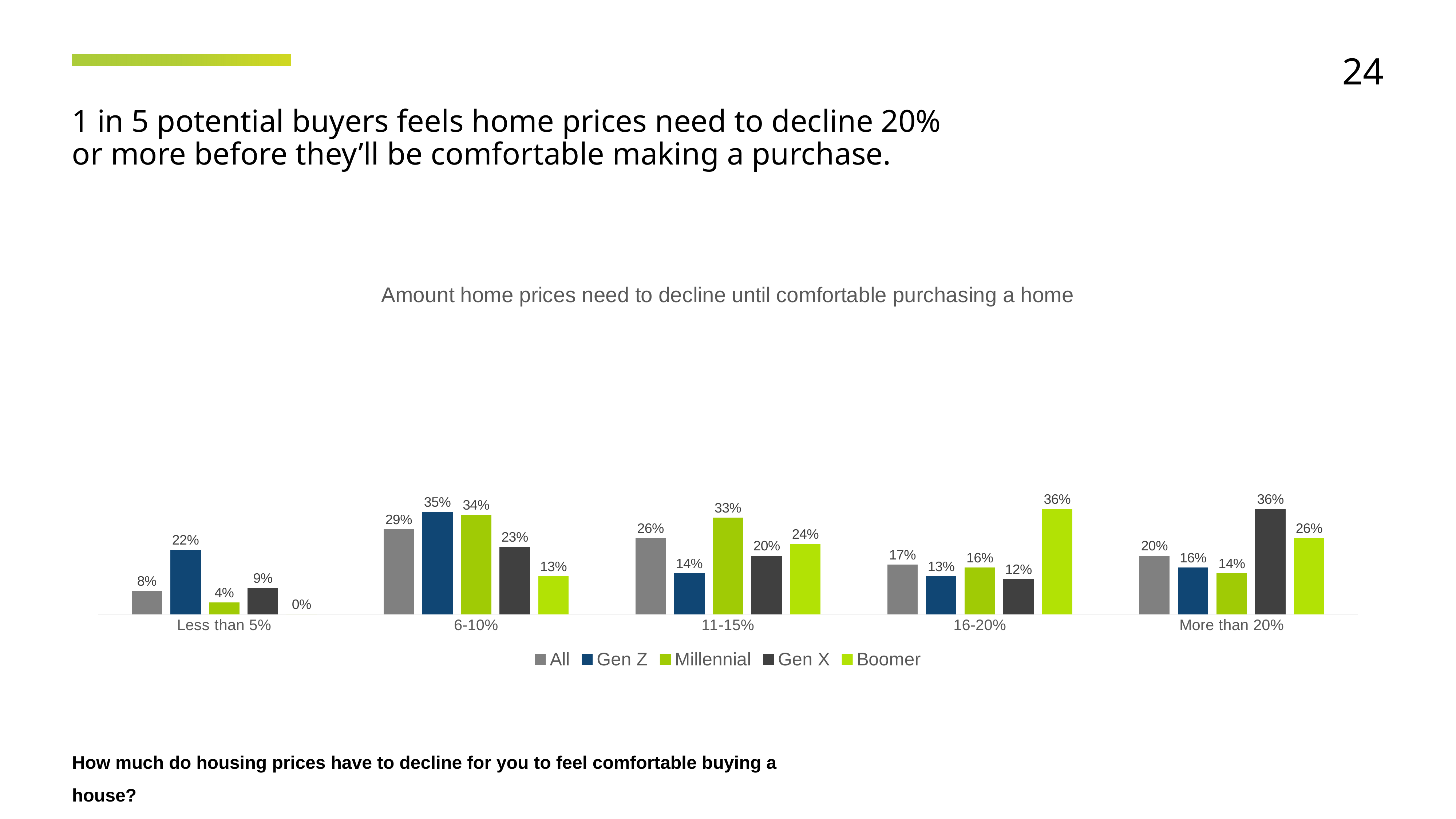
How many series does the legend list? 5 Which is larger in the 'More than 20%' category: the value for All or the value for Boomer? Boomer What is the value for Boomer in the '16-20%' category? 36% How many categories are shown on the x axis? 5 Which series has the highest value in the '11-15%' category? Millennial What kind of chart is shown on the slide? Bar chart What is the difference between the Gen Z and Millennial values in the '6-10%' category? 1% What is the title of the chart? Amount home prices need to decline until comfortable purchasing a home What is the value for Gen X in the 'More than 20%' category? 36% What is the value for Gen Z in the 'Less than 5%' category? 22% Which series has the lowest value in the 'Less than 5%' category? Boomer What is the value for All in the '6-10%' category? 29%